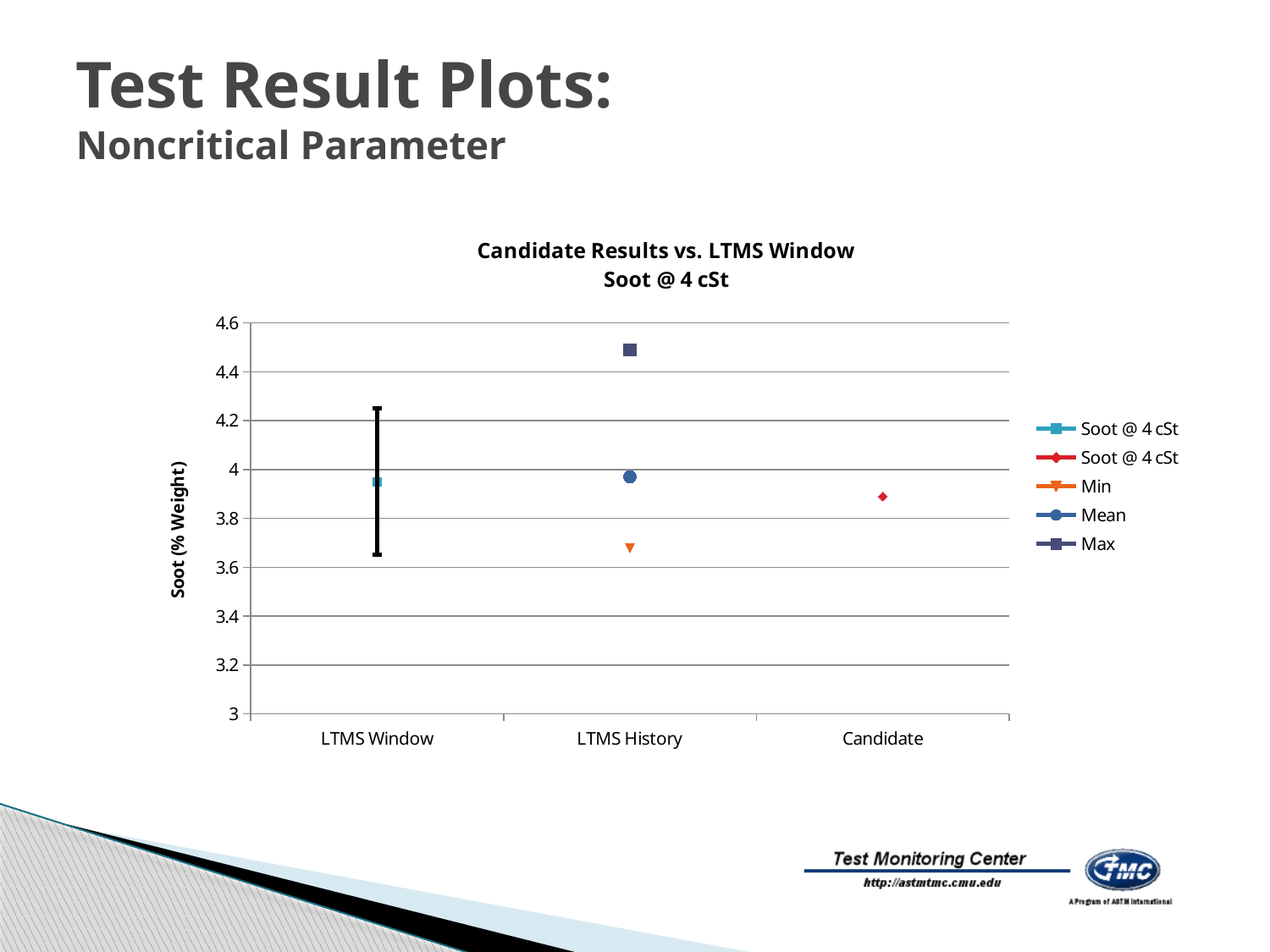
Is the Candidate value greater or less than 3.8? greater What is the title of the chart? Candidate Results vs. LTMS Window Soot @ 4 cSt Is the Max value for LTMS History greater or less than 4.4? greater How many series does the legend list? 5 How many categories are shown on the horizontal axis? 3 Is the Min value for LTMS History greater or less than 3.6? greater Which category has the highest plotted point on the chart? LTMS History What is the label of the vertical axis? Soot (% Weight) For LTMS History, which is larger, the Max value or the Min value? Max Which is larger, the Max value for LTMS History or the Candidate value? Max value for LTMS History